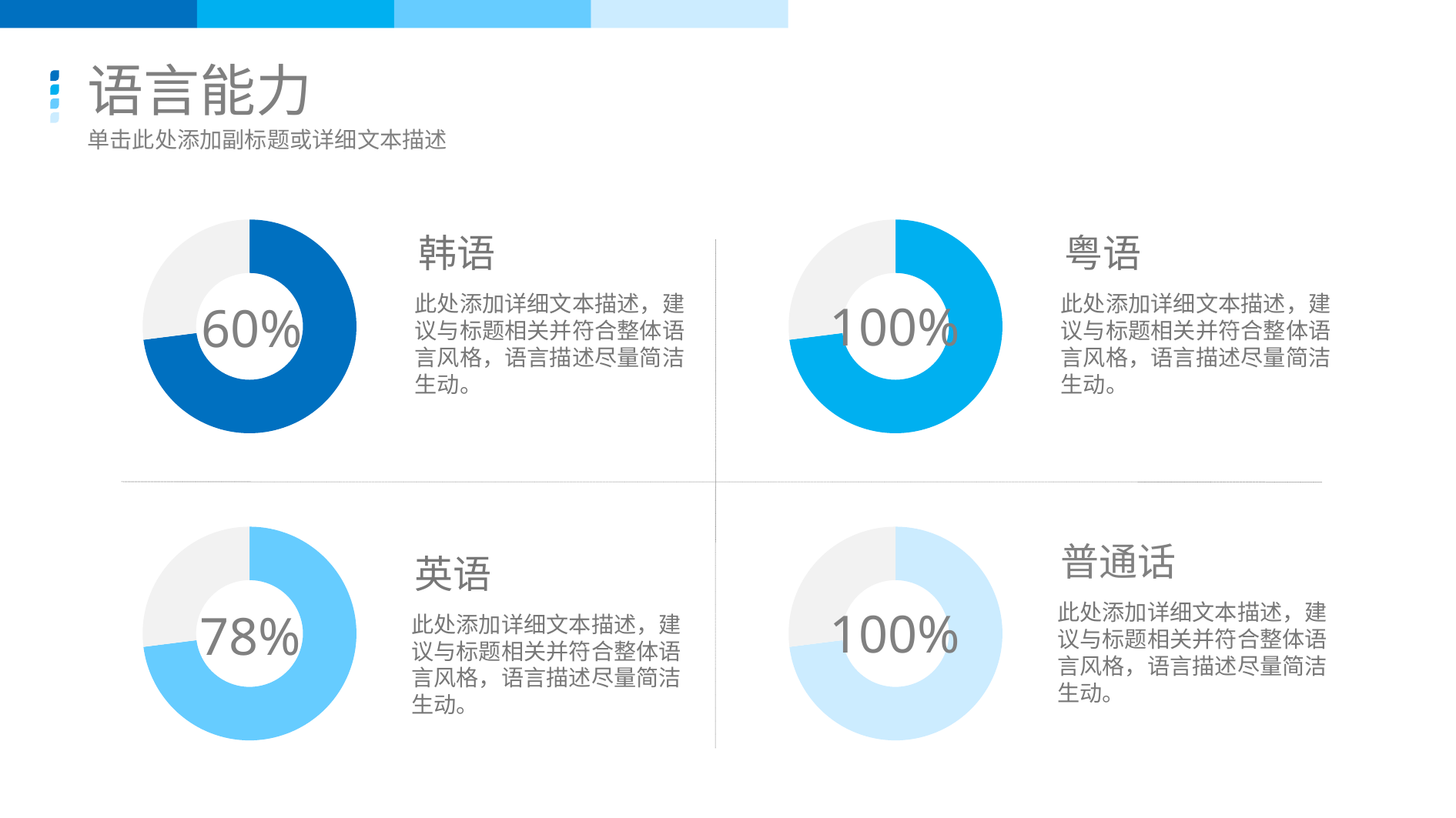
What kind of chart is used for each language on the slide? Donut chart What percentage is shown in the donut chart for 英语? 78% What percentage is shown in the donut chart for 韩语? 60% Which language's donut chart is drawn in the darkest blue? 韩语 How many donut charts are on the slide? 4 What percentage is shown in the donut chart for 粤语? 100% What is the difference between the percentages shown for 英语 and 韩语? 18% Which is larger, the percentage shown for 英语 or for 韩语? 英语 What percentage is shown in the donut chart for 普通话? 100% Which language has the lowest percentage shown on the slide? 韩语 What is the title of the slide? 语言能力 How many languages show a value of 100%? 2